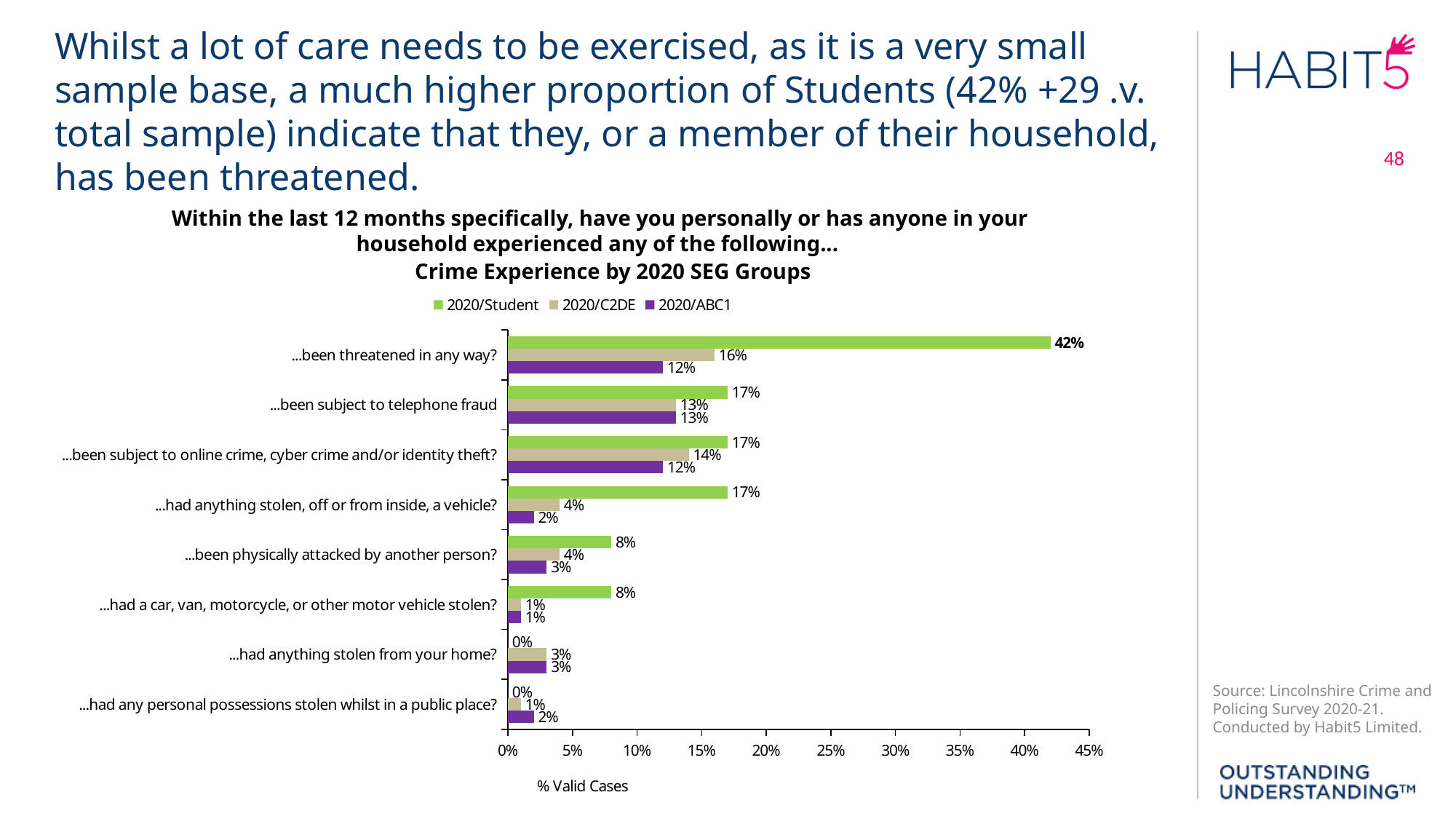
What is the 2020/C2DE value for "...been subject to online crime, cyber crime and/or identity theft?"? 14% What kind of chart is shown on the slide? Bar chart Which series is shown in green in the chart? 2020/Student How many series does the legend list? 3 What is the label on the horizontal axis of the chart? % Valid Cases What is the 2020/Student value for "...been threatened in any way?"? 42% Which category has the highest 2020/Student value? ...been threatened in any way? How many categories are shown on the chart? 8 For "...been physically attacked by another person?", which is larger: the 2020/Student value or the 2020/ABC1 value? 2020/Student What is the 2020/ABC1 value for "...had anything stolen, off or from inside, a vehicle?"? 2% What is the difference between the 2020/Student and 2020/C2DE values for "...been threatened in any way?"? 26% Which category has the lowest 2020/ABC1 value? ...had a car, van, motorcycle, or other motor vehicle stolen?